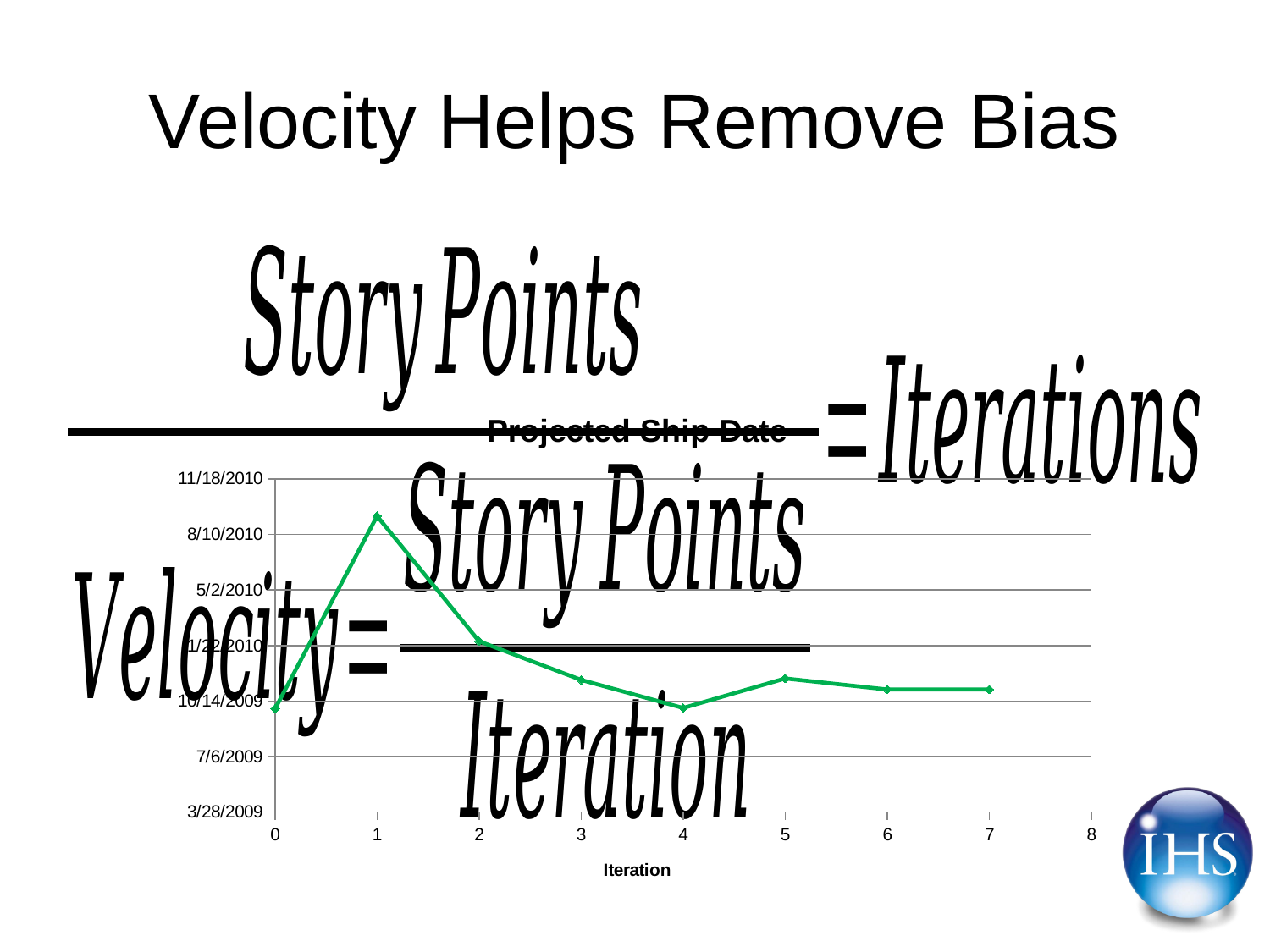
Does the projected ship date rise or fall from iteration 1 to iteration 4? fall At which iteration is the projected ship date the latest (highest point)? 1 What kind of chart is shown on the slide? line chart Is the projected ship date at iteration 0 later or earlier than 1/22/2010? earlier What is the title of the chart? Projected Ship Date Which has the later projected ship date, iteration 2 or iteration 4? iteration 2 Is the projected ship date at iteration 2 later or earlier than 5/2/2010? earlier What is the label of the x axis of the chart? Iteration Which has the later projected ship date, iteration 1 or iteration 3? iteration 1 Is the projected ship date at iteration 3 later or earlier than 1/22/2010? earlier How many data points are plotted on the line? 8